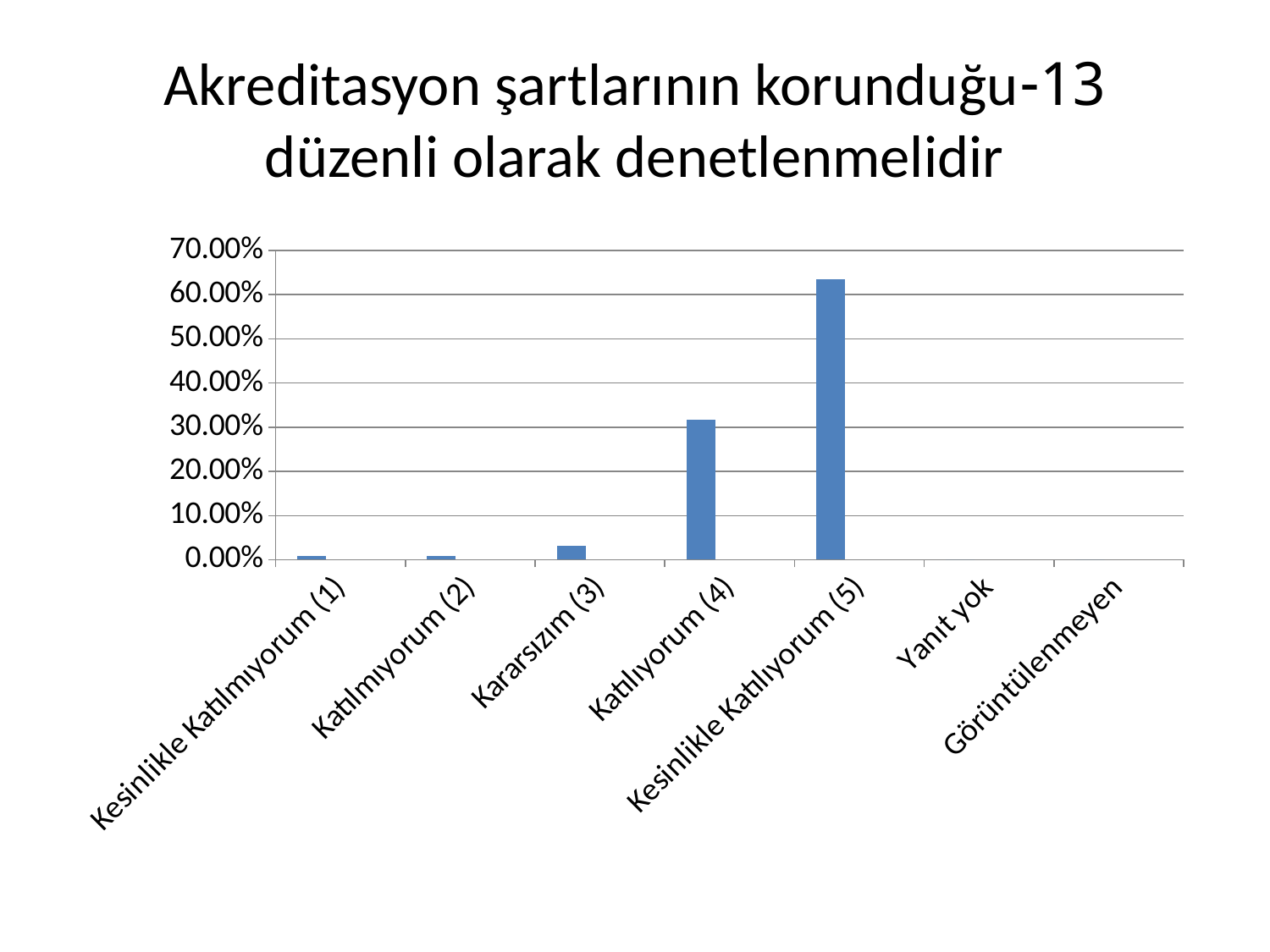
Is the value for Kararsızım (3) greater or less than 10.00%? less Which is larger, the value for Katılıyorum (4) or the value for Kesinlikle Katılıyorum (5)? Kesinlikle Katılıyorum (5) Which is larger, the value for Kararsızım (3) or the value for Katılıyorum (4)? Katılıyorum (4) What is the title of the slide containing the chart? Akreditasyon şartlarının korunduğu-13 düzenli olarak denetlenmelidir Which category has the highest value in the chart? Kesinlikle Katılıyorum (5) How many categories are shown on the x axis of the chart? 7 What kind of chart is shown on the slide? bar chart What is the highest value shown on the y axis of the chart? 70.00% Is the value for Kesinlikle Katılıyorum (5) greater or less than 70.00%? less Is the value for Katılıyorum (4) greater or less than 40.00%? less